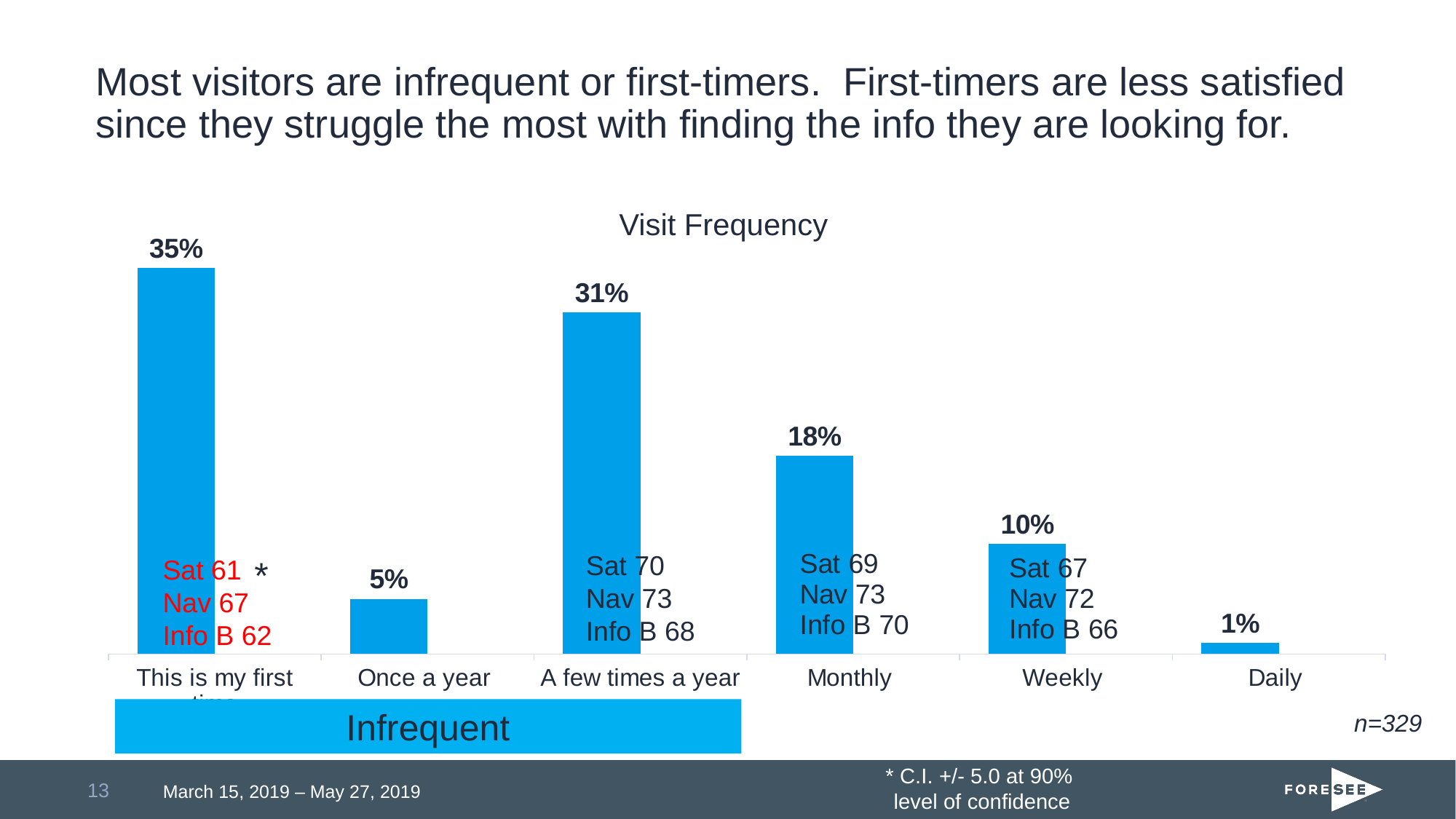
Which category has the highest value in the Visit Frequency chart? This is my first time Which category has the lowest value in the Visit Frequency chart? Daily How many categories are shown in the Visit Frequency chart? 6 What kind of chart is the Visit Frequency chart? Bar chart What is the value for 'A few times a year' in the Visit Frequency chart? 31% What is the difference between the values for 'This is my first time' and 'A few times a year'? 4% What is the difference between the values for 'Monthly' and 'Weekly'? 8% What is the title of the chart? Visit Frequency What is the value for 'Monthly' in the Visit Frequency chart? 18% Which is larger, the value for 'Once a year' or the value for 'Weekly'? Weekly What is the Sat score annotated for the 'Weekly' category? 67 What is the value for 'Daily' in the Visit Frequency chart? 1%